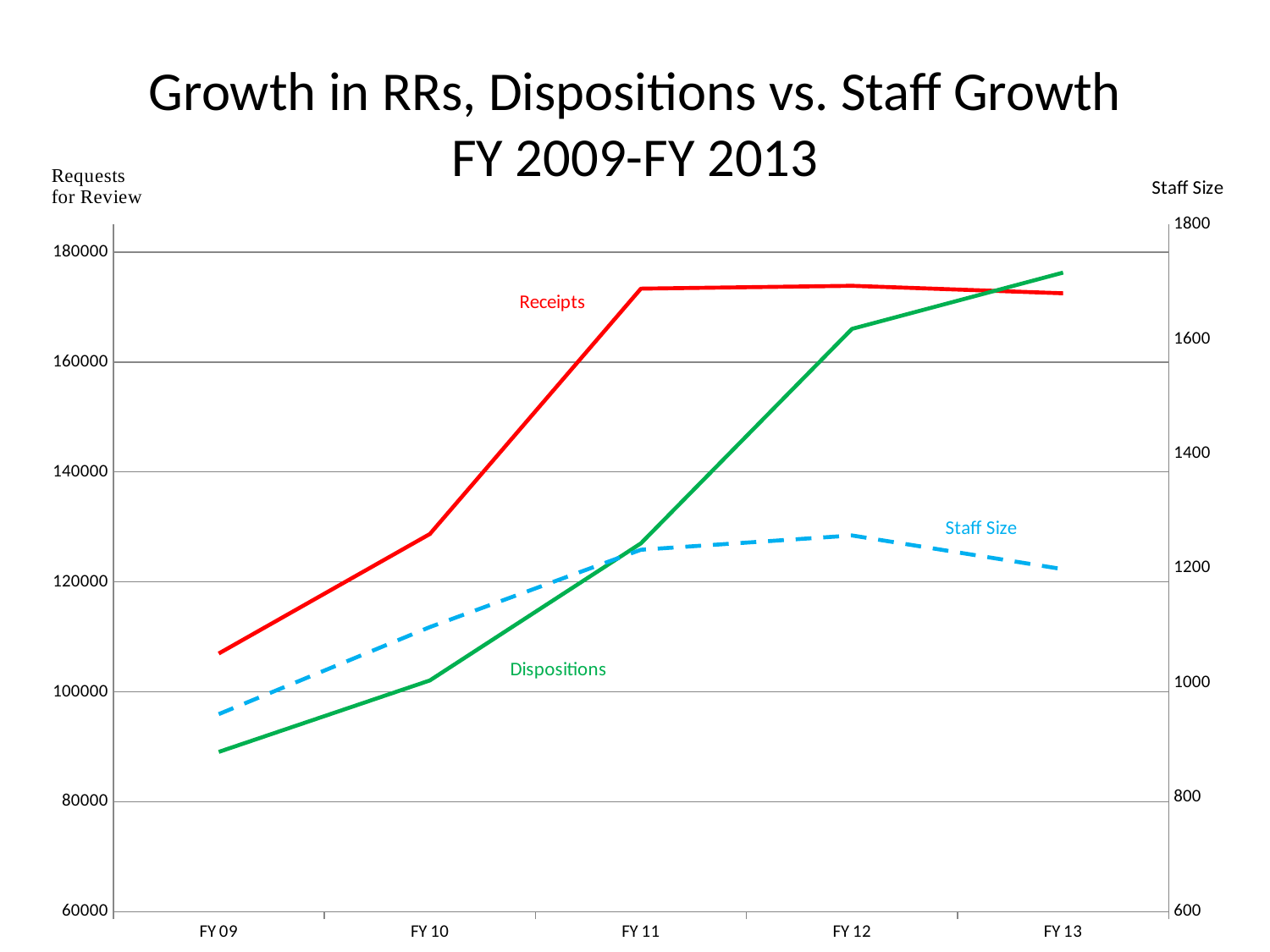
How many fiscal years are plotted along the x axis? 5 Is the Staff Size value for FY 09 greater or less than 1000? less In which fiscal year is Staff Size at its highest? FY 12 In FY 13, which is larger, Receipts or Dispositions? Dispositions Is the Receipts value for FY 11 greater or less than 160000? greater Is the Receipts value for FY 09 greater or less than 100000? greater What kind of chart is shown on the slide? line chart How many data series are plotted on the chart? 3 Do the Dispositions values rise or fall from FY 09 to FY 13? rise In FY 09, which is larger, Receipts or Dispositions? Receipts